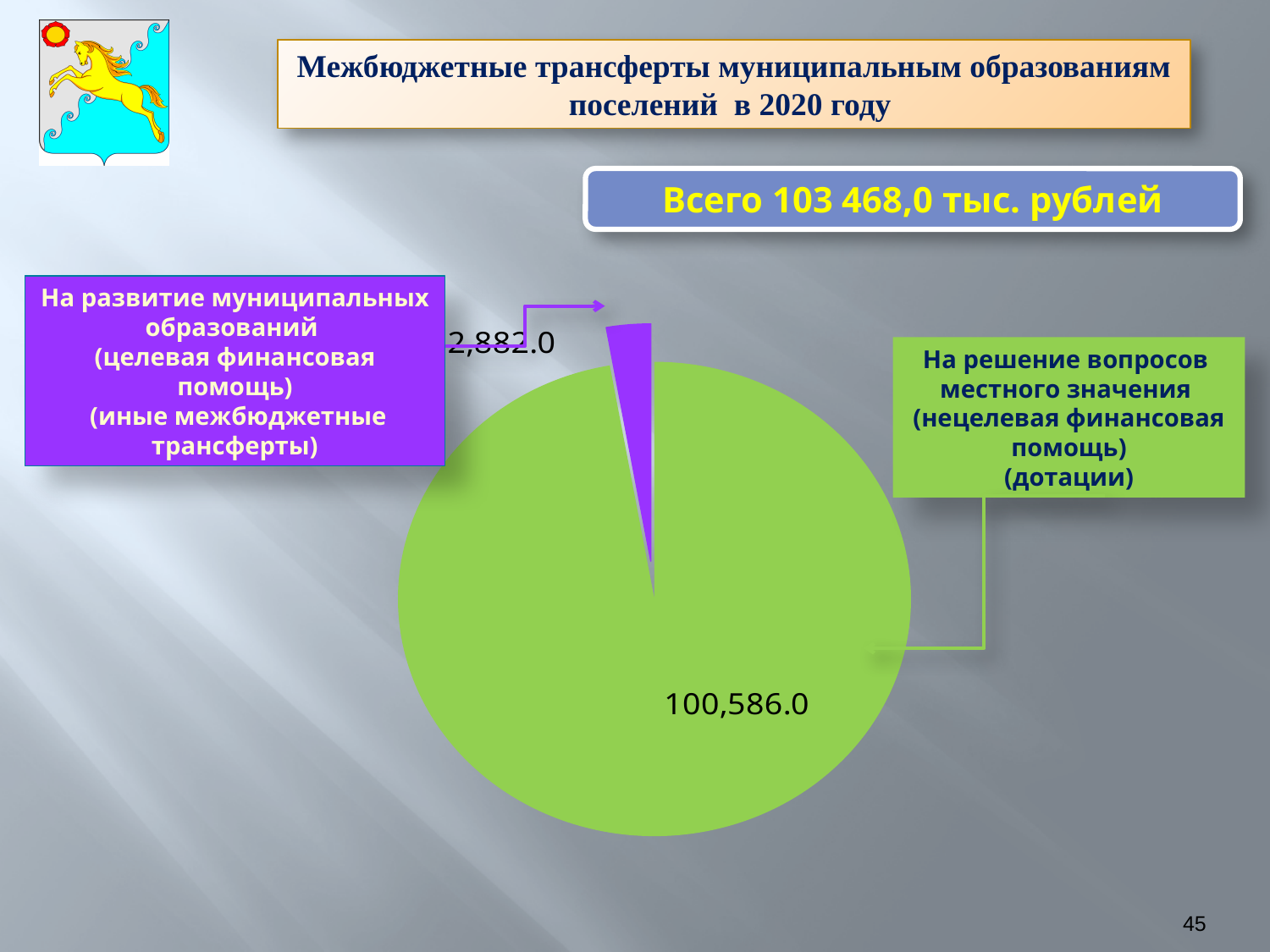
What is the value of the purple slice (На развитие муниципальных образований, иные межбюджетные трансферты)? 2,882.0 What is the total amount of intergovernmental transfers shown on the slide? 103 468,0 тыс. рублей How many slices does the pie chart have? 2 Which category has the smallest slice of the pie? На развитие муниципальных образований (иные межбюджетные трансферты) What is the value of the green slice (На решение вопросов местного значения, дотации)? 100,586.0 What colour is the slice for дотации (нецелевая финансовая помощь)? green Which category has the largest slice of the pie? На решение вопросов местного значения (дотации) What type of chart is shown on the slide? pie chart Which is larger: the value for дотации or the value for иные межбюджетные трансферты? дотации What year does the chart title refer to? 2020 What is the difference between the value for дотации and the value for иные межбюджетные трансферты? 97,704.0